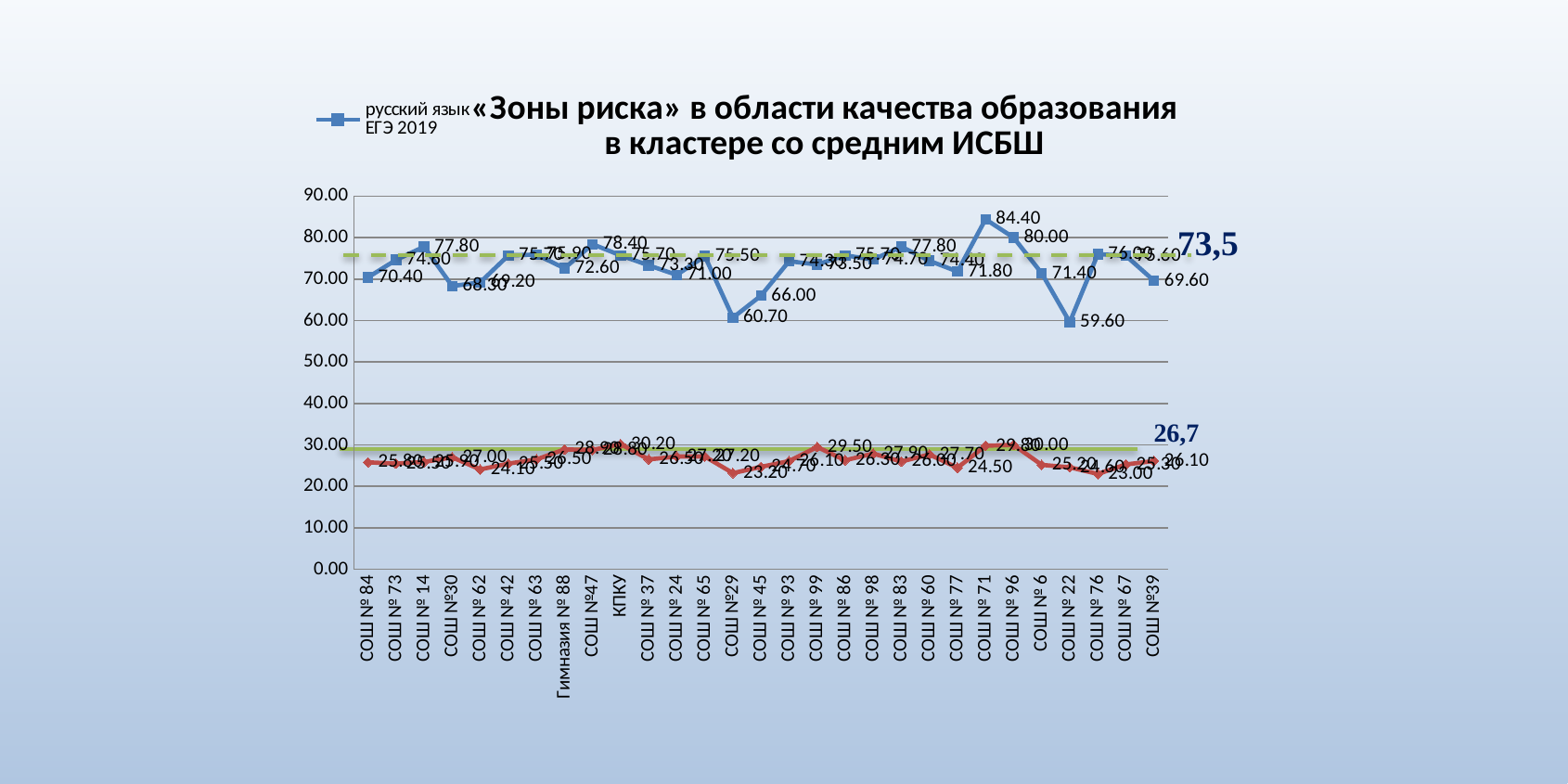
Which school has the lowest value on the blue line (русский язык ЕГЭ 2019)? СОШ № 22 What is the blue line value for СОШ № 22? 59.60 What is the blue line value for СОШ №29? 60.70 How many schools (categories) are shown on the x axis? 29 Which school has the highest value on the blue line (русский язык ЕГЭ 2019)? СОШ № 71 Is the blue line value for СОШ № 45 greater or less than 70.00? less Which has a higher blue line value, СОШ № 71 or СОШ № 22? СОШ № 71 What value is labelled on the upper dashed green reference line? 73,5 What is the highest value on the blue line (русский язык ЕГЭ 2019)? 84.40 What is the blue line value for СОШ № 96? 80.00 What type of chart is shown on the slide? line chart What is the difference between the highest blue line value (СОШ № 71) and the lowest (СОШ № 22)? 24.80